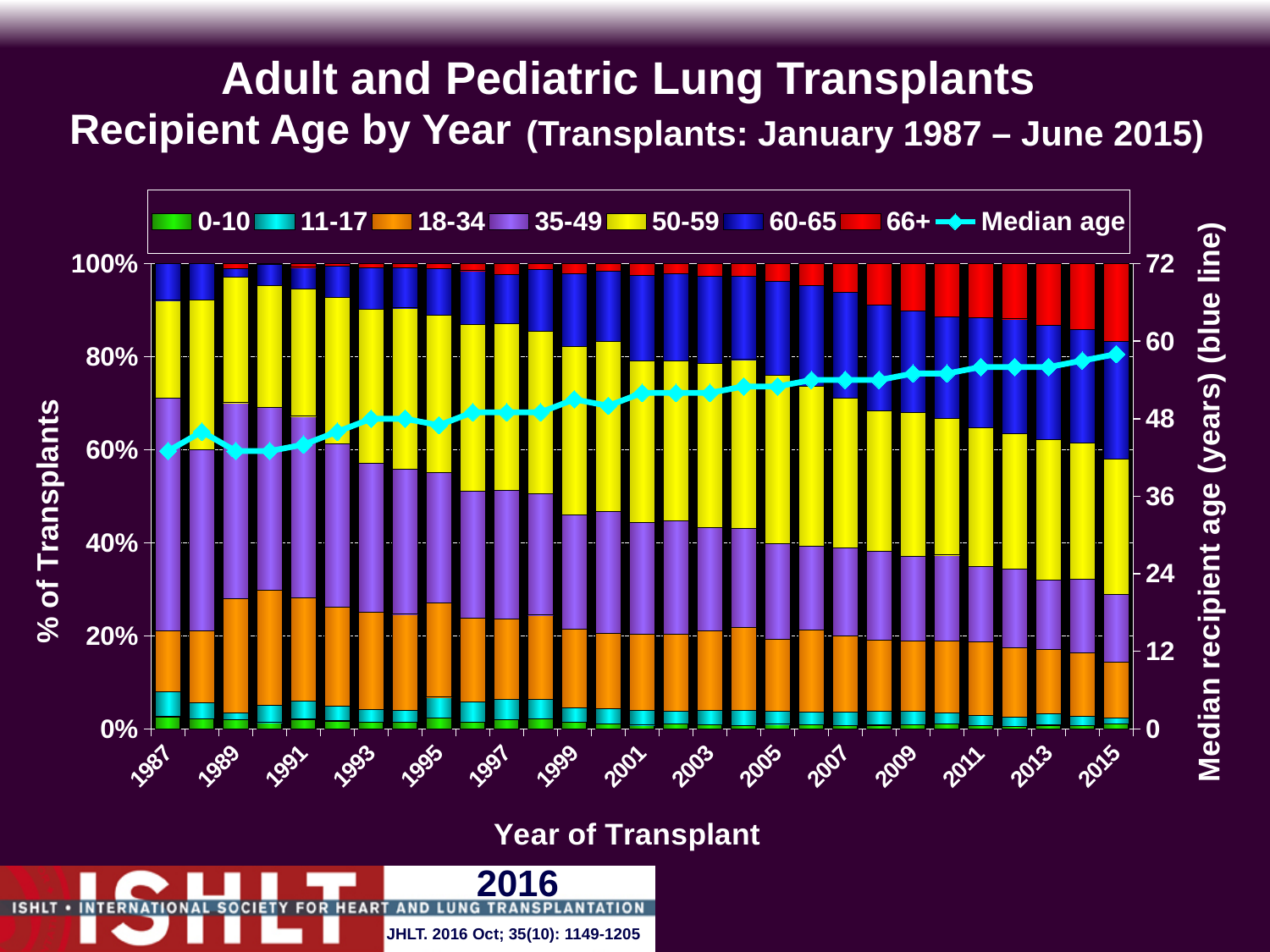
Which year has the highest median recipient age? 2015 What is the total height of each stacked bar on the left axis? 100% Which colour represents the 50-59 age group in the legend? yellow Is the median recipient age in 2015 greater or less than 48 years? greater What is the label of the x axis? Year of Transplant How many years (bars) are plotted along the x axis? 29 Does the median recipient age rise or fall from 1987 to 2015? rise How many entries does the legend list? 8 Which year has the larger median recipient age, 1987 or 2015? 2015 What kind of chart is shown on the slide? stacked bar chart with a line Is the median recipient age in 1987 greater or less than 36 years? greater Does the share of the 66+ age group rise or fall over the years shown? rise